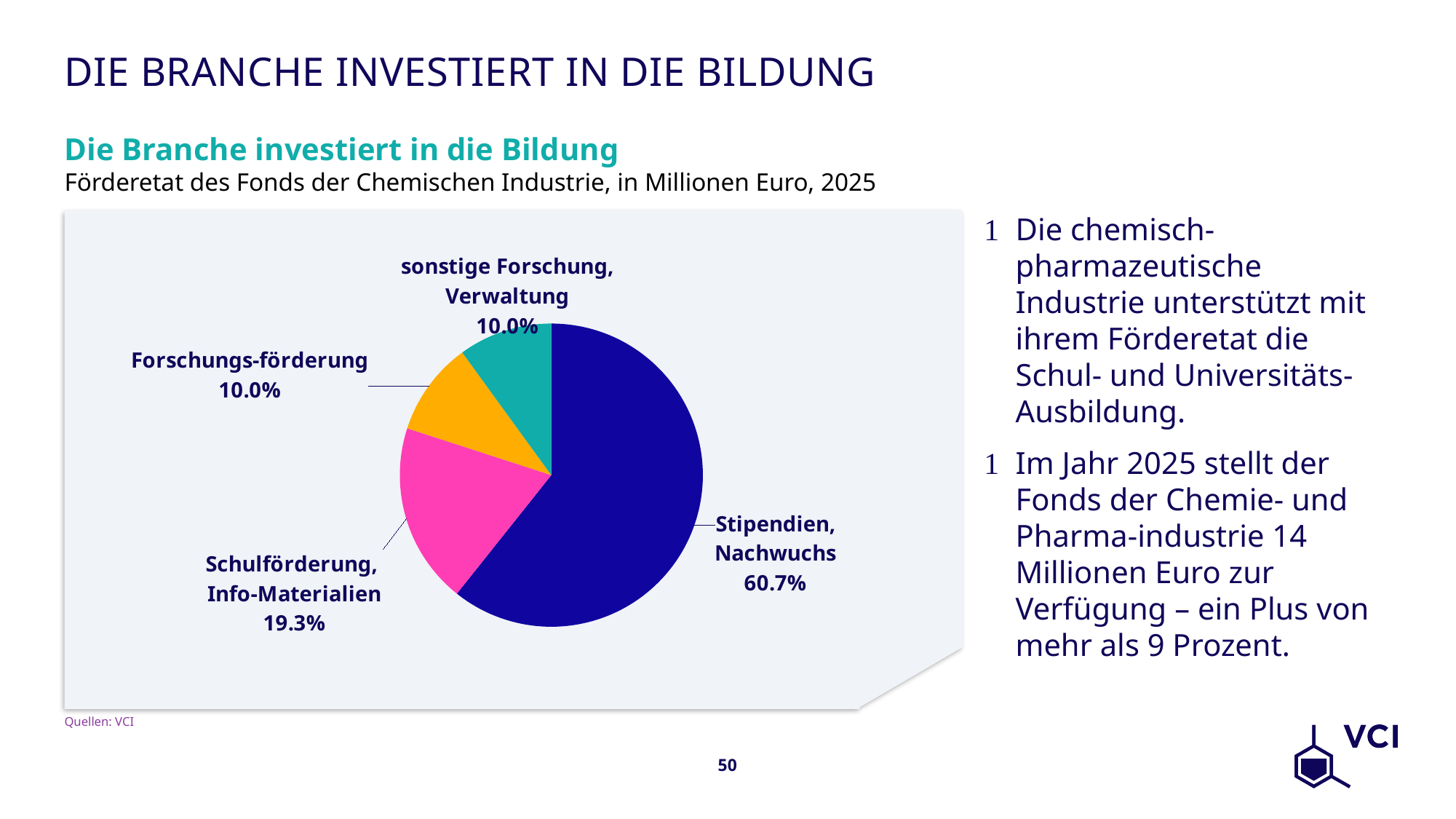
What colour is the slice for Stipendien, Nachwuchs? dark blue How many slices does the pie chart have? 4 What is the difference in percentage points between Stipendien, Nachwuchs and Schulförderung, Info-Materialien? 41.4 Is the share for Stipendien, Nachwuchs greater or less than 50%? greater What share of the pie does Forschungs-förderung have? 10.0% What kind of chart is shown on the slide? pie chart Which category has the largest slice of the pie? Stipendien, Nachwuchs What is the title of the chart? Die Branche investiert in die Bildung What share of the pie does Stipendien, Nachwuchs have? 60.7% What share of the pie does Schulförderung, Info-Materialien have? 19.3% Which is larger: the share for Schulförderung, Info-Materialien or the share for Forschungs-förderung? Schulförderung, Info-Materialien